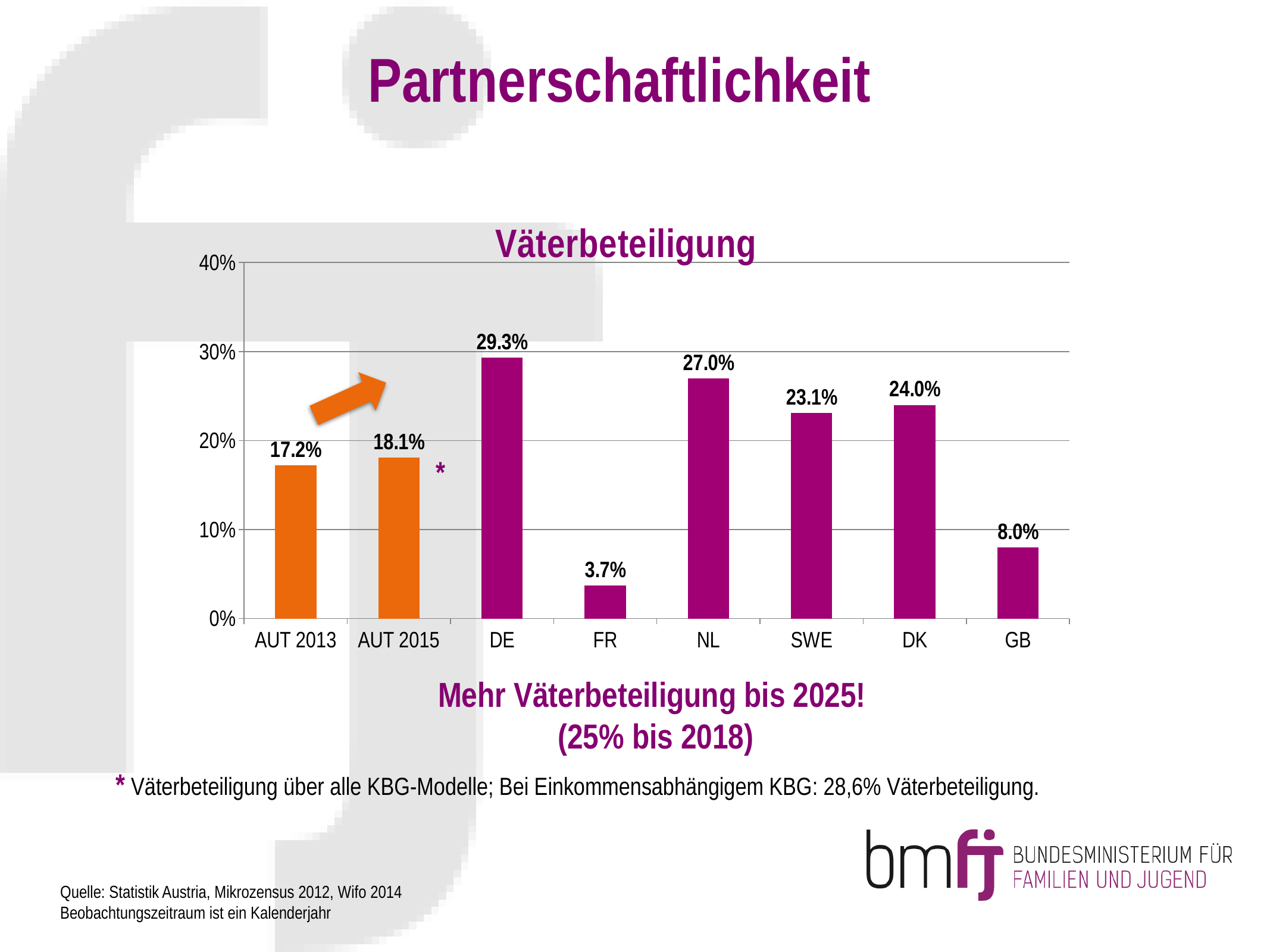
Which category has the lowest value? FR What kind of chart is shown? bar chart What is the difference between the values for AUT 2015 and AUT 2013? 0.9% What is the title of the chart? Väterbeteiligung Which is larger, the value for SWE or the value for DK? DK What is the value for AUT 2015? 18.1% Which category has the highest value? DE What is the difference between the values for NL and DK? 3.0% Is the value for GB greater or less than 10%? less What is the value for FR? 3.7% How many categories are shown on the x axis? 8 What is the value for DE? 29.3%